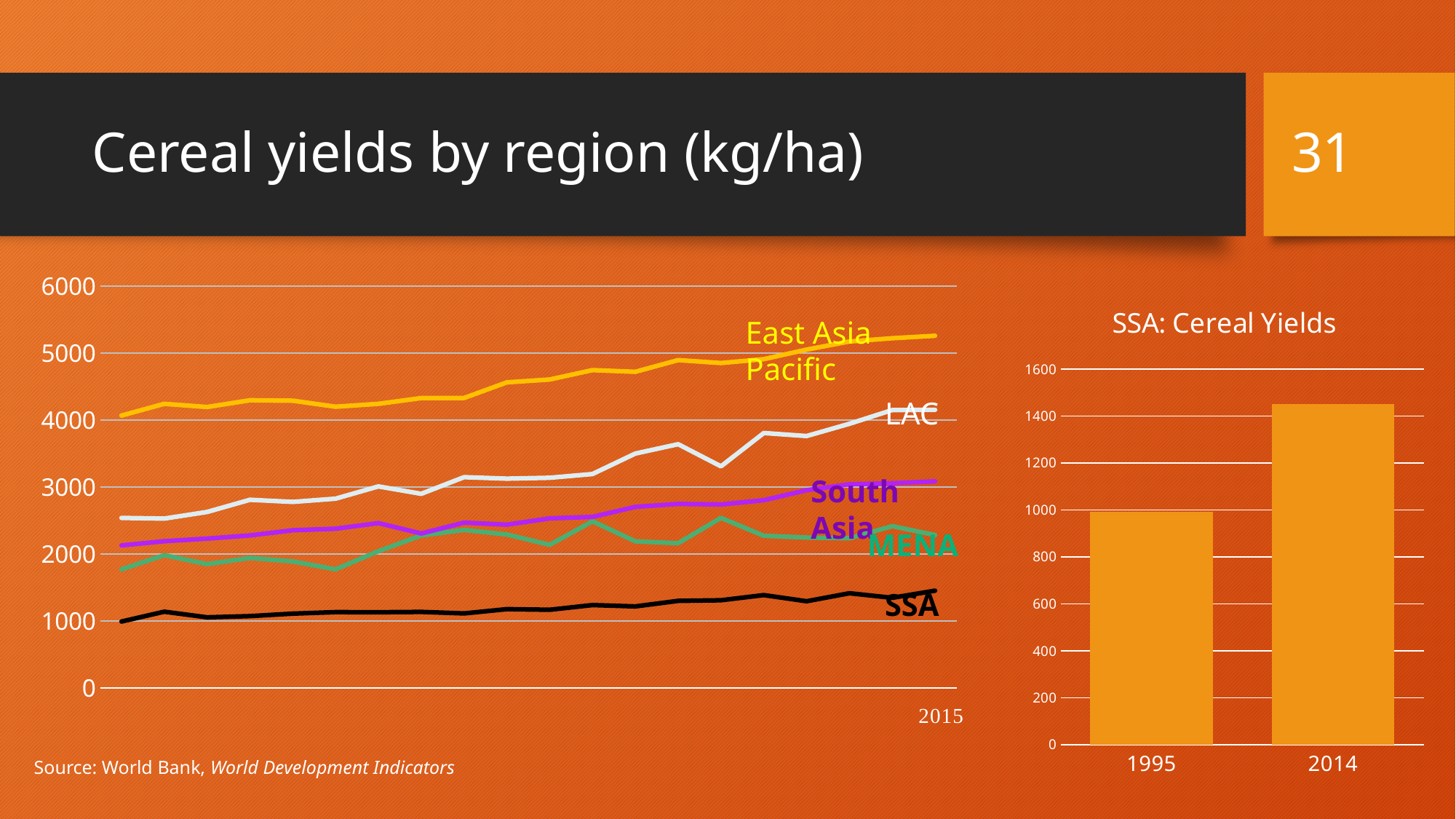
In the 'SSA: Cereal Yields' bar chart, is the value for 2014 greater or less than 1200? greater In the 'SSA: Cereal Yields' bar chart, how many bars are shown? 2 In the 'Cereal yields by region (kg/ha)' line chart, which region has the lowest cereal yields? SSA In the 'Cereal yields by region (kg/ha)' line chart, is the value for East Asia Pacific at the end of the series greater or less than 5000? greater What kind of chart is the chart on the right titled 'SSA: Cereal Yields'? bar chart What kind of chart is the chart on the left titled 'Cereal yields by region (kg/ha)'? line chart In the 'Cereal yields by region (kg/ha)' line chart, how many regions are plotted? 5 In the 'Cereal yields by region (kg/ha)' line chart, is the value for LAC at the end of the series greater or less than 3000? greater In the 'SSA: Cereal Yields' bar chart, which year has the higher bar, 1995 or 2014? 2014 In the 'Cereal yields by region (kg/ha)' line chart, does the East Asia Pacific line rise or fall over time? rise In the 'Cereal yields by region (kg/ha)' line chart, which region has the highest cereal yields? East Asia Pacific